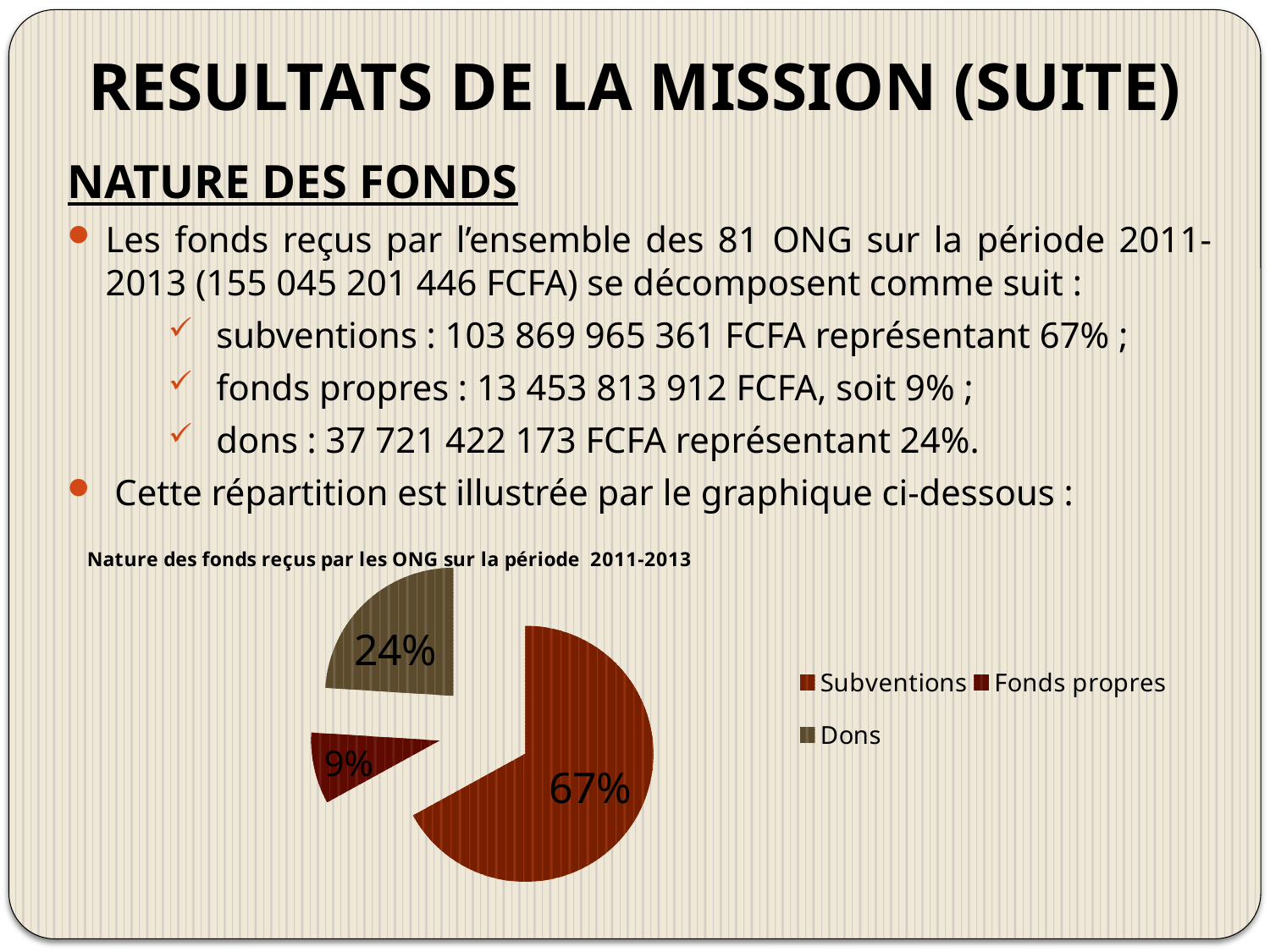
What share of the pie does Dons represent? 24% Which category has the largest slice of the pie? Subventions How many slices does the pie chart have? 3 What share of the pie does Fonds propres represent? 9% How many entries does the legend list? 3 What is the difference in percentage points between Subventions and Dons? 43 Which category has the smallest slice of the pie? Fonds propres What share of the pie does Subventions represent? 67% What kind of chart is shown on the slide? pie chart What is the title of the chart? Nature des fonds reçus par les ONG sur la période 2011-2013 Which is larger, the share for Dons or the share for Fonds propres? Dons What is the difference in percentage points between Dons and Fonds propres? 15